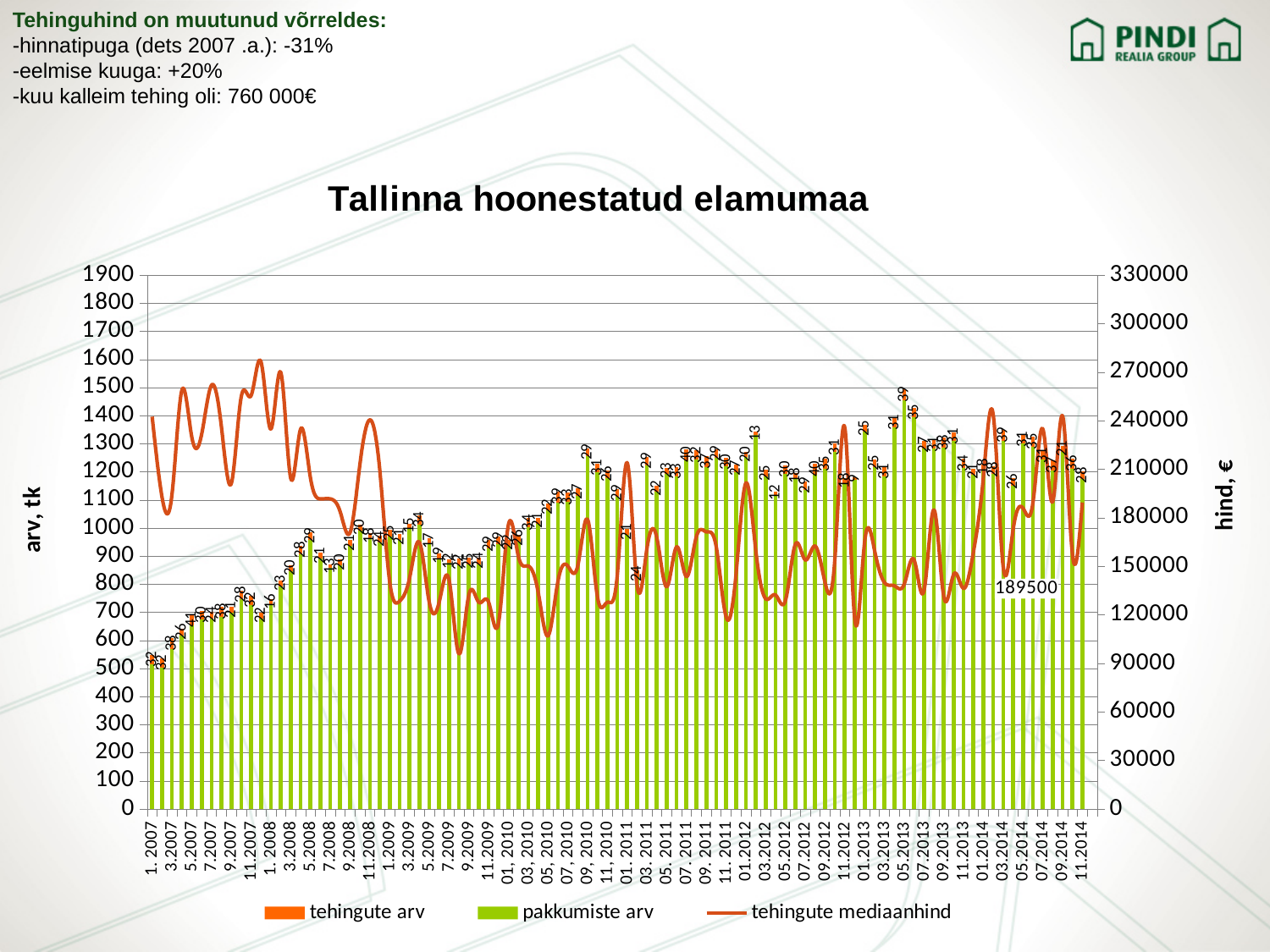
Which is larger, the pakkumiste arv for 1.2007 or for 11.2014? 11.2014 Is the pakkumiste arv value for 05.2013 greater or less than 1400? greater Does the pakkumiste arv rise or fall from 1.2007 to 11.2008? rise Is the pakkumiste arv value for 1.2007 greater or less than 600? less Is the tehingute mediaanhind value for 9.2009 greater or less than 120000? greater What are the three series named in the legend? tehingute arv, pakkumiste arv, tehingute mediaanhind What kind of chart is shown on the slide? Combined bar and line chart Does the tehingute mediaanhind line overall rise or fall from 1.2007 to 9.2009? fall What value is printed as a data label on the tehingute mediaanhind line near the end of the series (around 2014)? 189500 How many series does the chart legend list? 3 What is the title of the chart? Tallinna hoonestatud elamumaa